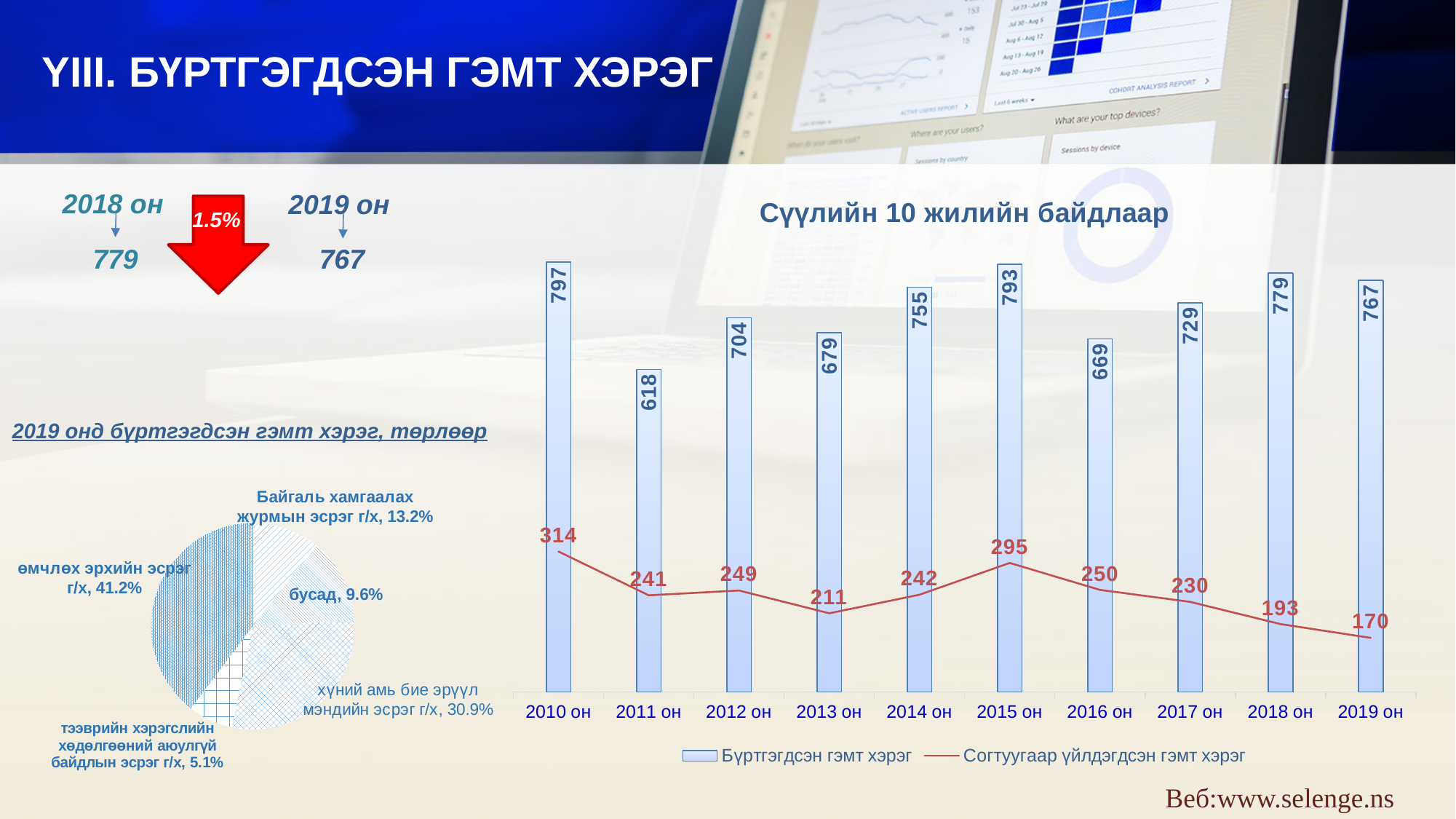
In the pie chart titled '2019 онд бүртгэгдсэн гэмт хэрэг, төрлөөр', which category has the smallest share? тээврийн хэрэгслийн хөдөлгөөний аюулгүй байдлын эсрэг г/х In the chart titled 'Сүүлийн 10 жилийн байдлаар', what is the difference between the 'Бүртгэгдсэн гэмт хэрэг' values for 2018 он and 2019 он? 12 In the chart titled 'Сүүлийн 10 жилийн байдлаар', what is the value of 'Согтуугаар үйлдэгдсэн гэмт хэрэг' for 2013 он? 211 In the chart titled 'Сүүлийн 10 жилийн байдлаар', what is the value of 'Бүртгэгдсэн гэмт хэрэг' for 2015 он? 793 In the pie chart titled '2019 онд бүртгэгдсэн гэмт хэрэг, төрлөөр', what share does 'өмчлөх эрхийн эсрэг г/х' have? 41.2% In the chart titled 'Сүүлийн 10 жилийн байдлаар', how many series does the legend list? 2 In the chart titled 'Сүүлийн 10 жилийн байдлаар', how many years are shown on the x axis? 10 What type of chart is the one on the left of the slide titled '2019 онд бүртгэгдсэн гэмт хэрэг, төрлөөр'? pie chart In the chart titled 'Сүүлийн 10 жилийн байдлаар', which year has the lowest value of 'Согтуугаар үйлдэгдсэн гэмт хэрэг'? 2019 он In the chart titled 'Сүүлийн 10 жилийн байдлаар', is the 'Бүртгэгдсэн гэмт хэрэг' value for 2012 он or 2014 он larger? 2014 он In the chart titled 'Сүүлийн 10 жилийн байдлаар', which year has the highest value of 'Бүртгэгдсэн гэмт хэрэг'? 2010 он In the chart titled 'Сүүлийн 10 жилийн байдлаар', does the 'Согтуугаар үйлдэгдсэн гэмт хэрэг' line rise or fall from 2015 он to 2019 он? fall